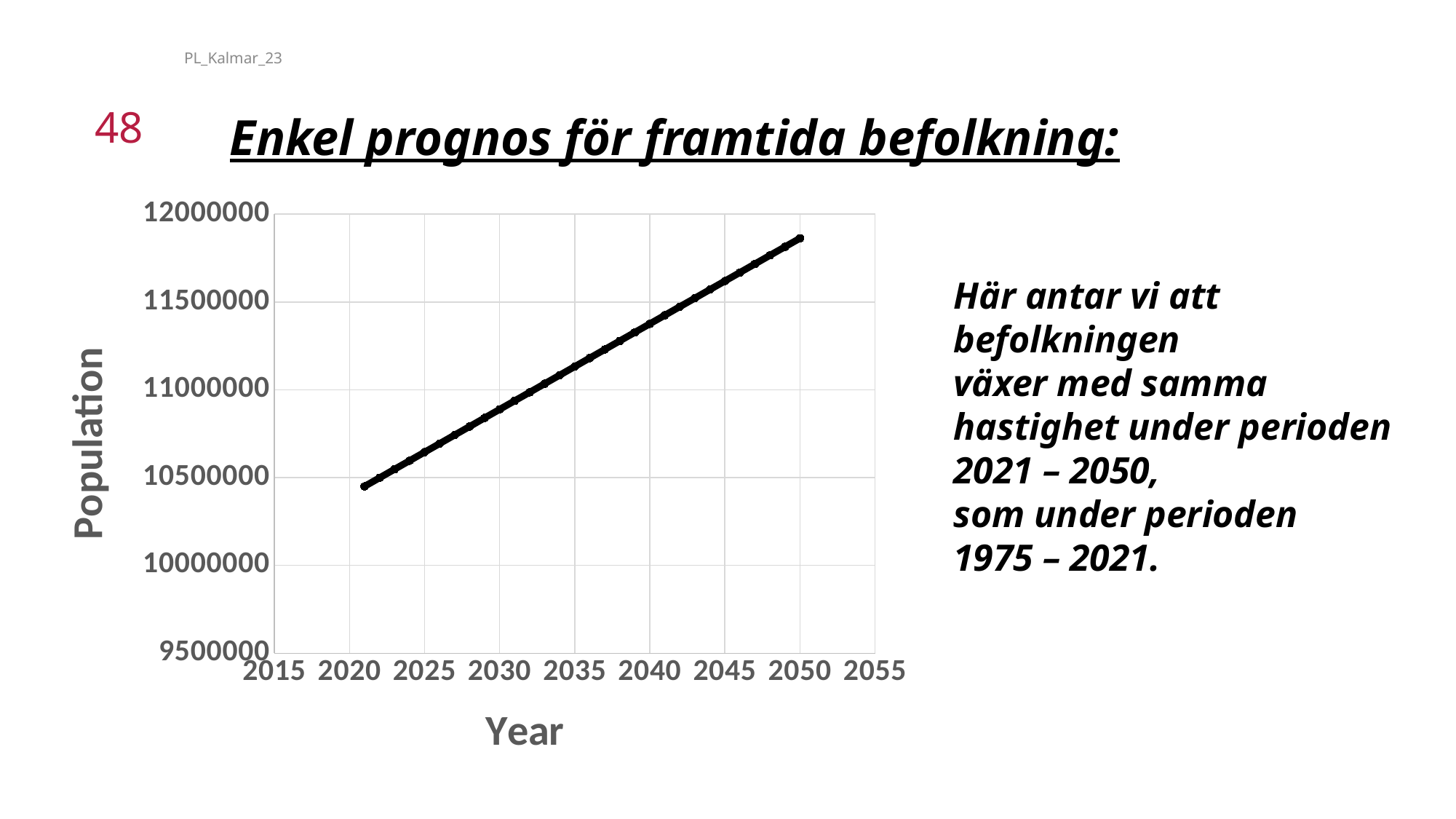
In which year is the plotted population lowest? 2021 What is the label on the vertical axis of the chart? Population In which year is the plotted population highest? 2050 What kind of chart is shown on the slide? line chart Is the population value for 2040 greater or less than 11500000? less Does the population rise or fall as the year increases along the x axis? rise Is the population value for 2021 greater or less than 10500000? less Which year has the larger population value, 2030 or 2045? 2045 Is the population value for 2035 greater or less than 11000000? greater